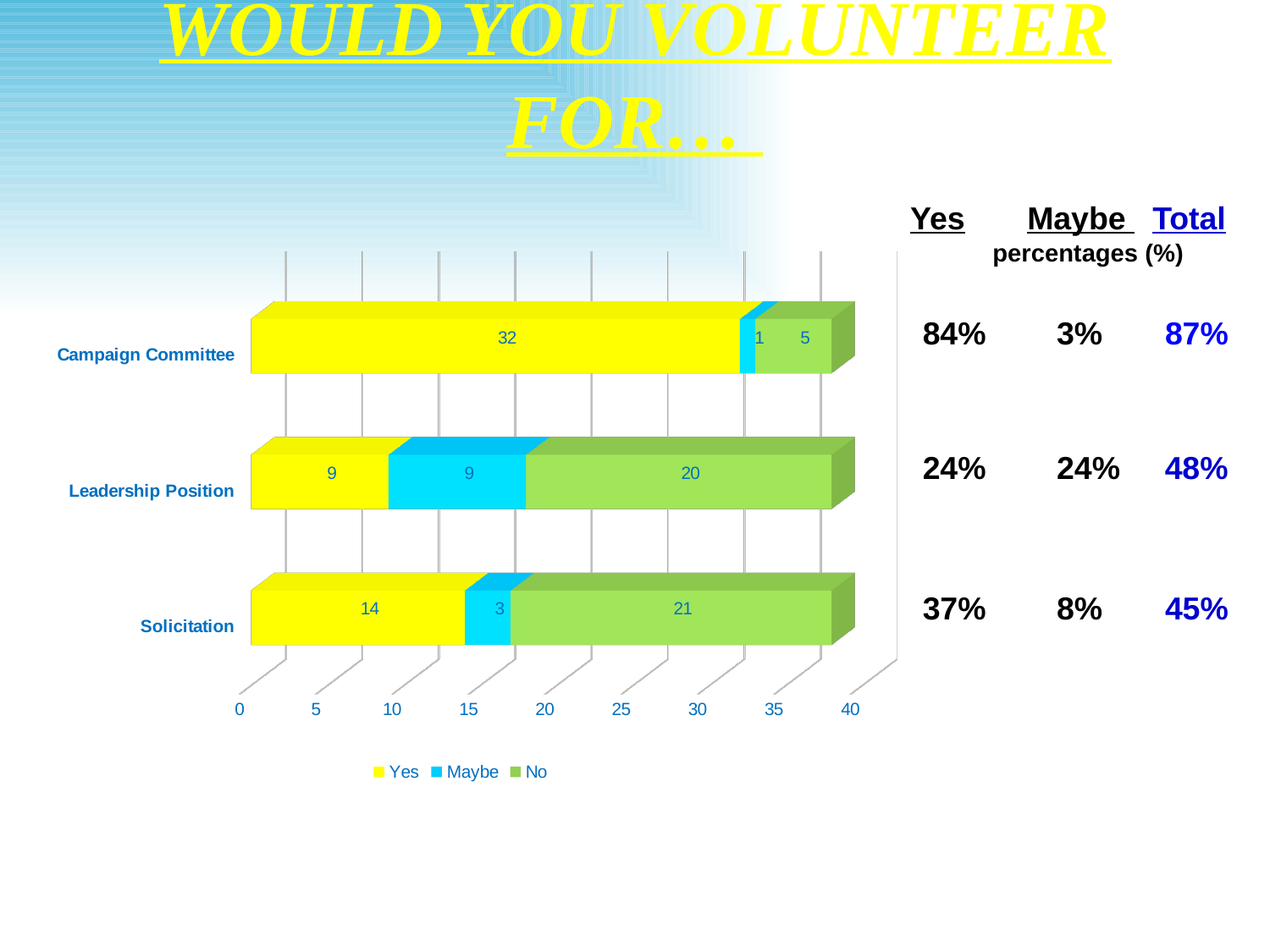
What is the difference between the Yes values for Campaign Committee and Solicitation? 18 What is the Maybe value for Solicitation? 3 What is the total of the stacked bar for Leadership Position? 38 What kind of chart is shown on the slide? Stacked bar chart Which is larger, the No value for Solicitation or the No value for Leadership Position? Solicitation Which category has the lowest No value? Campaign Committee How many categories are shown on the chart? 3 Which category has the highest Yes value? Campaign Committee What is the Yes value for Campaign Committee? 32 How many series does the legend list? 3 What is the No value for Leadership Position? 20 Which series is shown in yellow in the legend? Yes